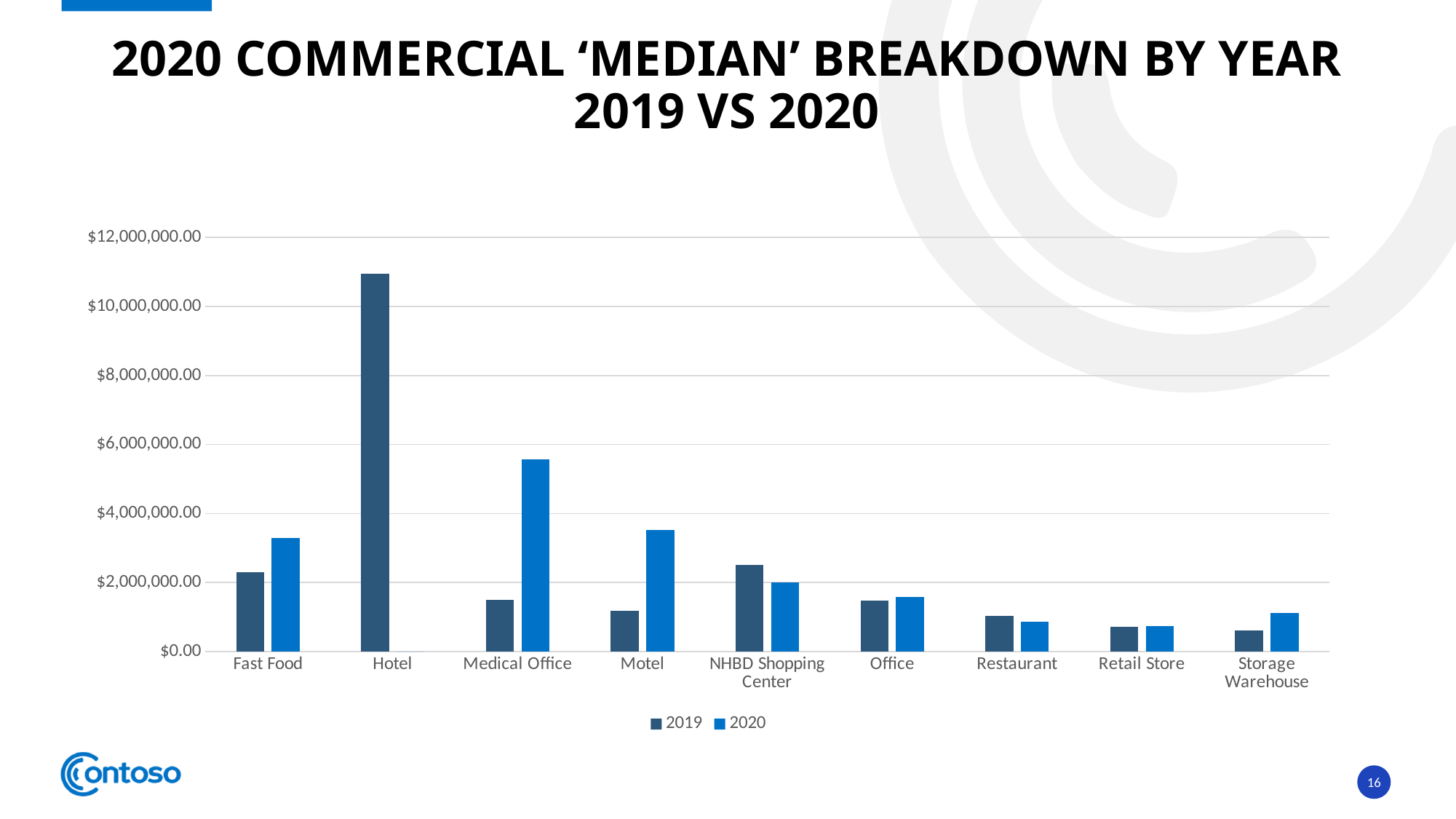
For Fast Food, which series has the larger value, 2019 or 2020? 2020 Is the 2020 value for Fast Food greater or less than $2,000,000.00? greater Which category has the highest 2020 value? Medical Office How many series does the legend list? 2 Is the 2019 value for Motel greater or less than $2,000,000.00? less How many categories are shown on the x axis? 9 What kind of chart is shown on the slide? Bar chart For NHBD Shopping Center, which series has the larger value, 2019 or 2020? 2019 Which category has the highest 2019 value? Hotel Is the 2020 value for Medical Office greater or less than $4,000,000.00? greater What is the title of the chart on the slide? 2020 COMMERCIAL ‘MEDIAN’ BREAKDOWN BY YEAR 2019 VS 2020